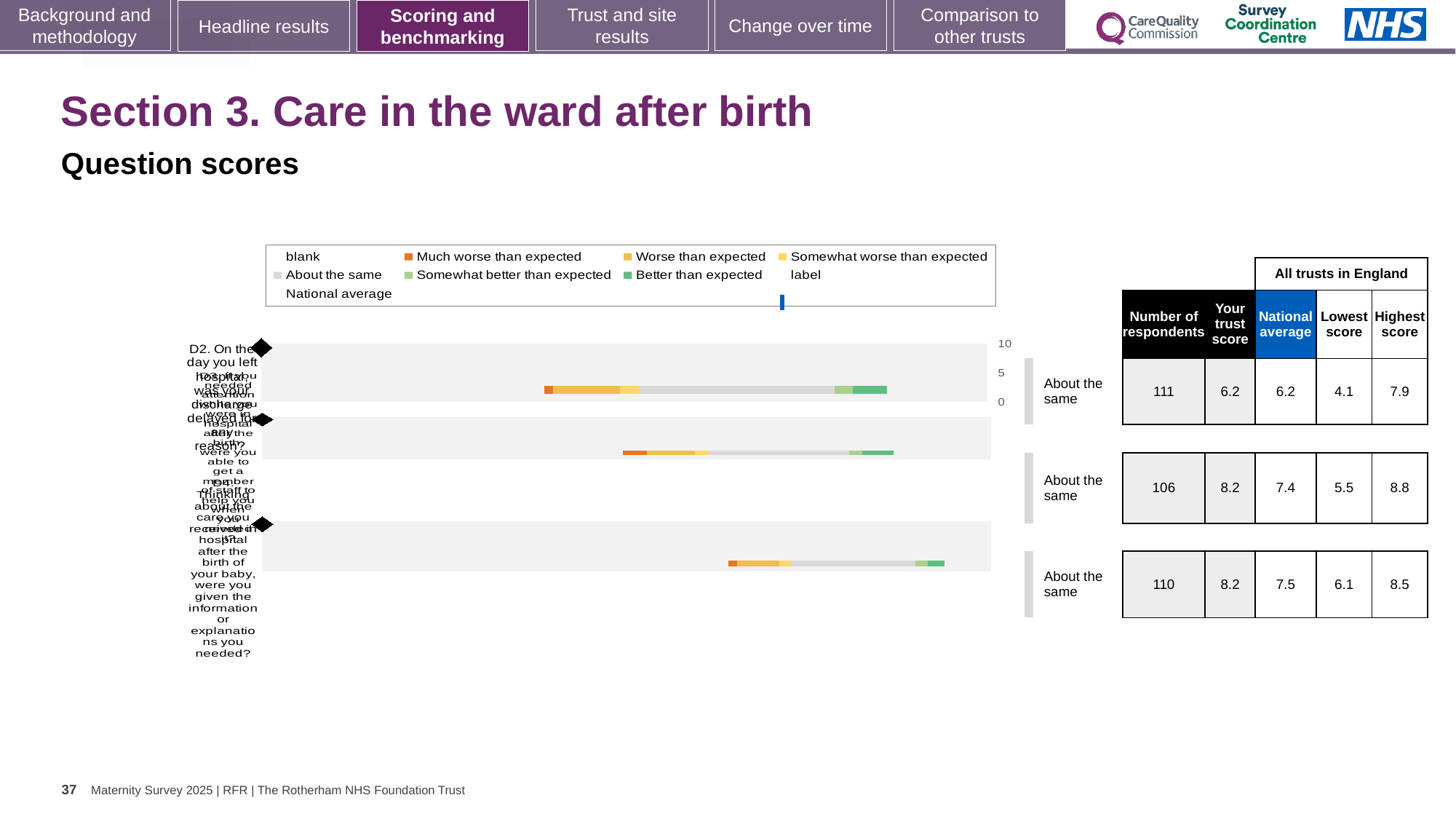
In the table beside the chart, which question row has the lowest 'Lowest score' value? the first (top) row, 4.1 In the table beside the chart, what is the number of respondents for the first (top) question row? 111 What kind of chart is shown on the slide? bar chart In the table beside the chart, what is the national average for the third (bottom) question row? 7.5 In the table beside the chart, what is the trust score for the second question row? 8.2 In the table beside the chart, what is the highest score in England for the second question row? 8.8 What colour does the legend use for 'Much worse than expected'? orange What benchmark category is shown for each of the three question rows? About the same What is the maximum value shown on the chart's score axis? 10 How many entries does the chart legend list? 9 In the table beside the chart, what is the difference between the trust score and the national average for the second question row? 0.8 How many bars (question rows) are plotted in the chart? 3